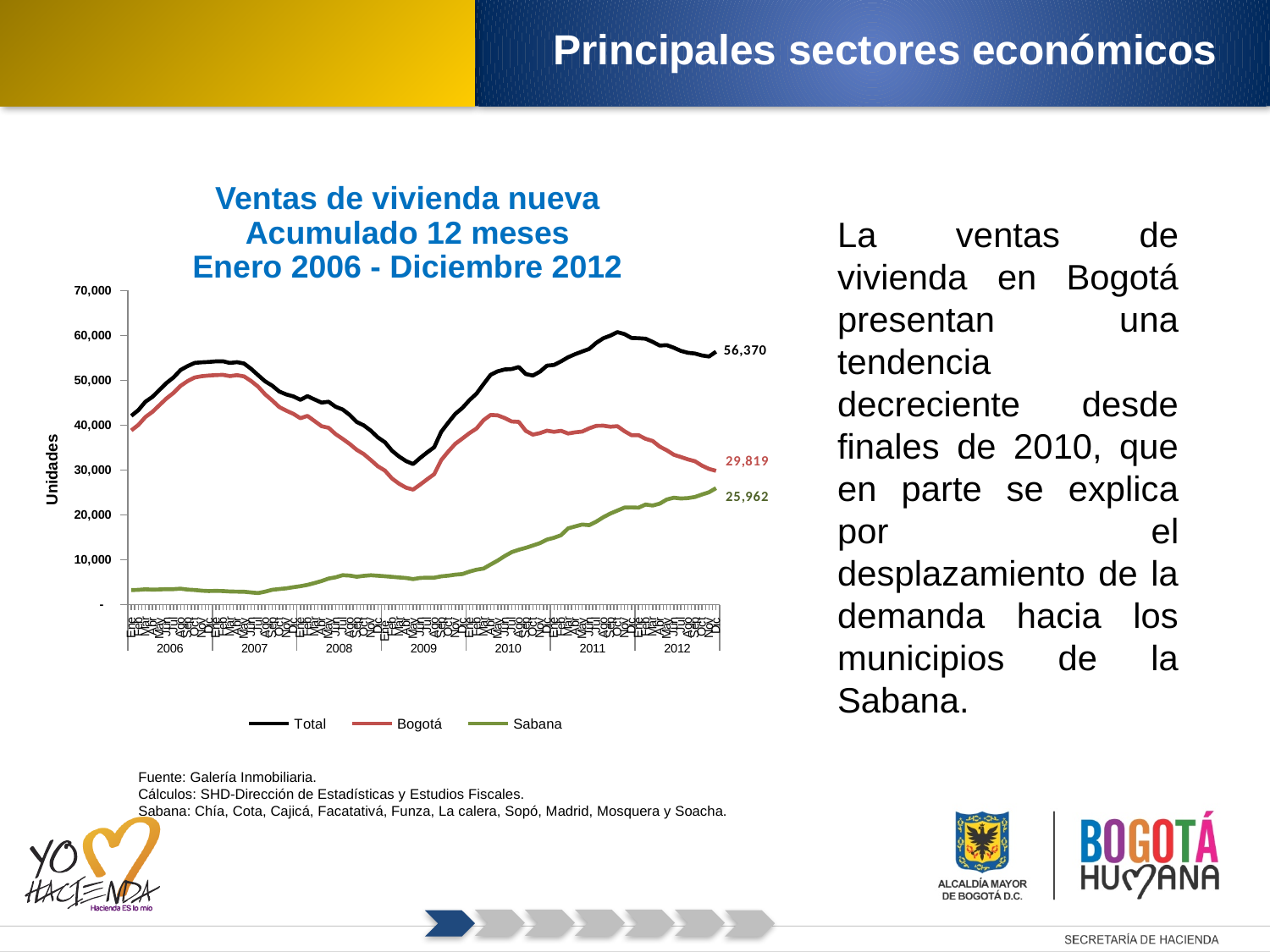
What is the difference between the final Total value and the final Bogotá value? 26,551 What is the difference between the final Bogotá value and the final Sabana value? 3,857 What is the final value shown for the Total series at the end of 2012? 56,370 Does the Sabana series rise or fall over the period from 2006 to 2012? Rise Is the lowest value of the Bogotá series in 2009 greater or less than 30,000? less What is the final value shown for the Sabana series? 25,962 How many series does the legend list? 3 What is the label on the vertical axis of the chart? Unidades What is the final value shown for the Bogotá series? 29,819 Is the value for Sabana at the start of 2006 greater or less than 10,000? less At the end of the period, which series has the larger value, Bogotá or Sabana? Bogotá What kind of chart is shown on the slide? Line chart